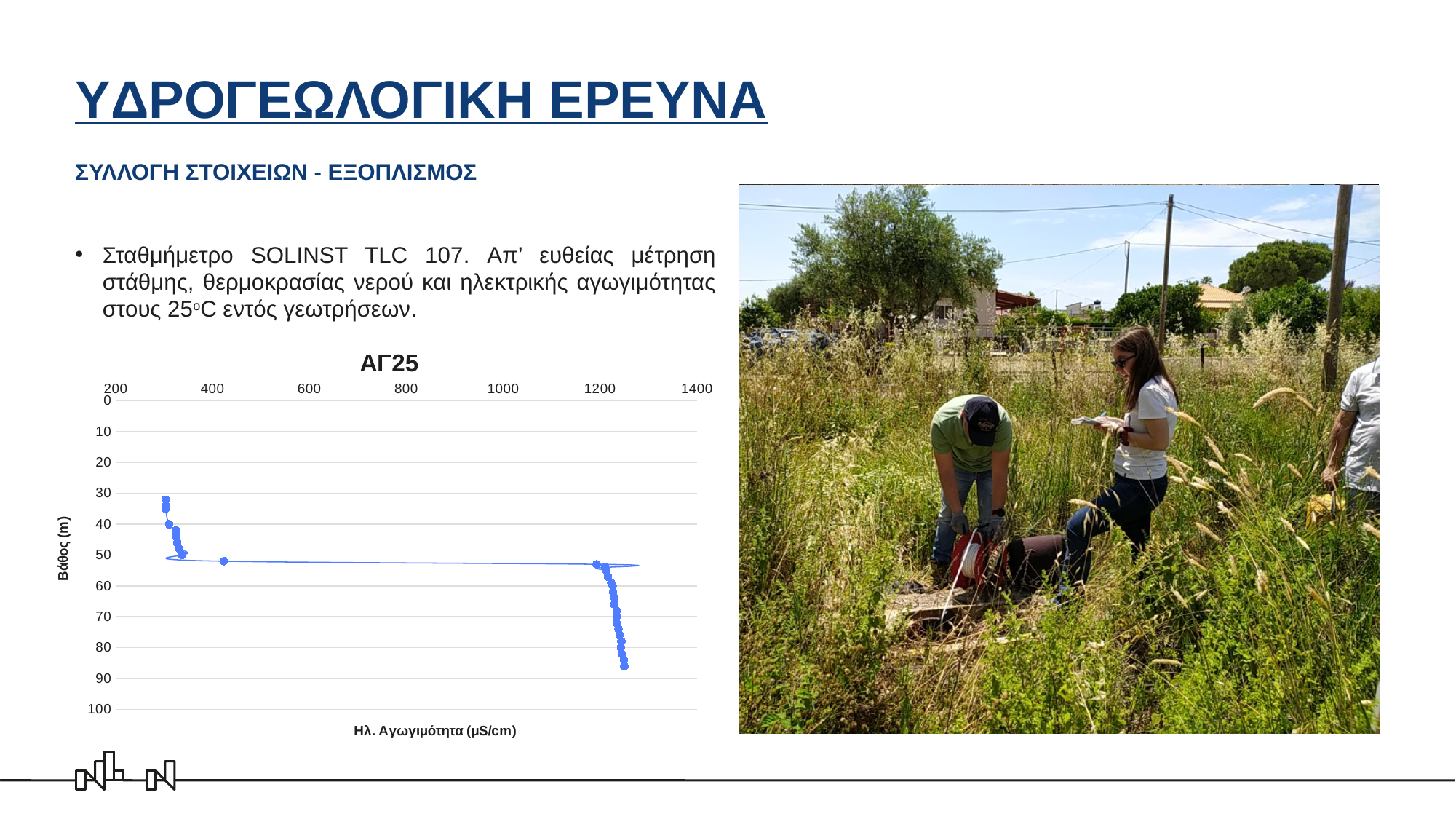
Is the conductivity value at a depth of 35 m greater or less than 600? less Which depth has the higher conductivity value, 40 m or 80 m? 80 m Which depth has the lower conductivity value, 45 m or 60 m? 45 m Is the conductivity value at a depth of 40 m greater or less than 400? less What is the title of the chart? ΑΓ25 Is the conductivity value at a depth of 70 m greater or less than 800? greater Overall, does the conductivity rise or fall as depth increases from 30 m to 90 m? rise What kind of chart is shown on the slide? scatter chart with a line What is the label of the horizontal axis of the chart? Ηλ. Αγωγιμότητα (μS/cm)